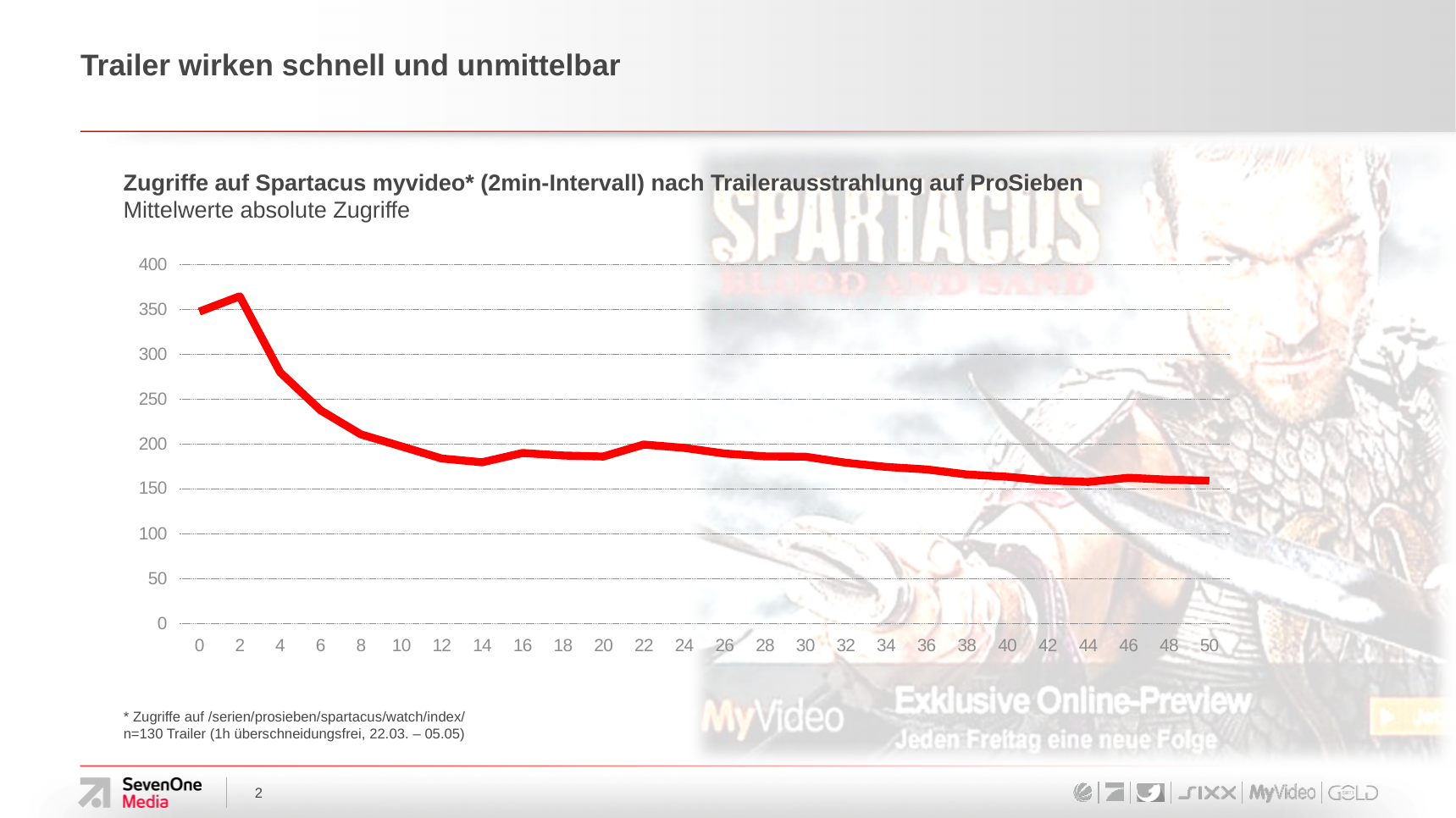
Is the value at x = 50 greater or less than 200? less Is the value at x = 0 greater or less than 300? greater How many data points are plotted along the x axis (from 0 to 50)? 26 What is the title of the chart? Zugriffe auf Spartacus myvideo* (2min-Intervall) nach Trailerausstrahlung auf ProSieben What is the subtitle shown under the chart title? Mittelwerte absolute Zugriffe What kind of chart is shown on the slide? line chart Is the value at x = 10 greater or less than 250? less Which x-axis value has the highest number of Zugriffe? 2 Do the values generally rise or fall along the x axis from 2 to 50? fall